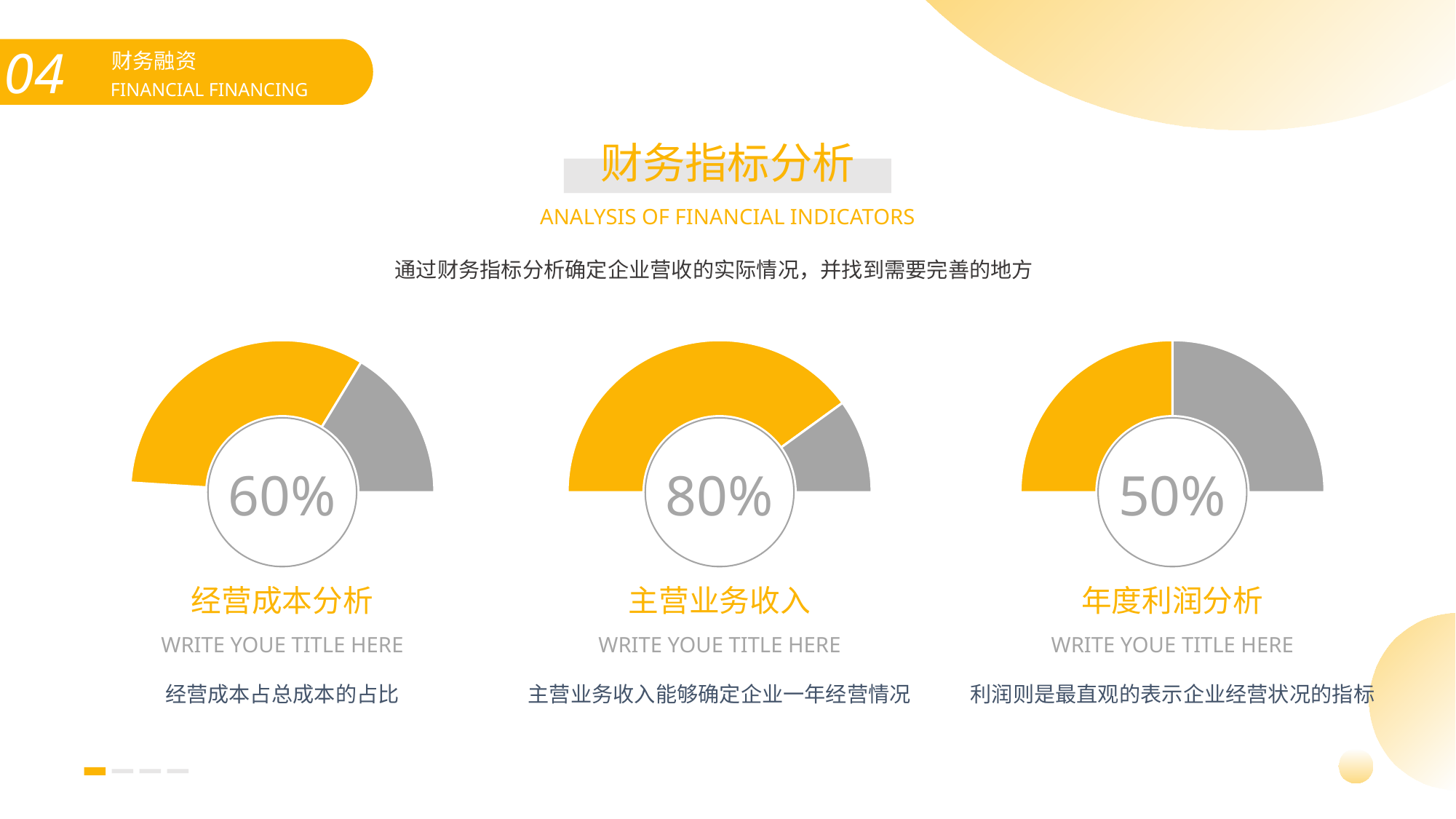
Which is larger, the value on the 经营成本分析 gauge or the value on the 年度利润分析 gauge? 经营成本分析 What value is shown on the gauge chart labelled 主营业务收入? 80% Which of the three gauge charts shows the highest value? 主营业务收入 What is the main title of the slide above the three gauge charts? 财务指标分析 What colour represents the filled portion of each gauge chart? Yellow/orange What kind of chart is used to display the three percentages on the slide? Gauge (semi-circular doughnut) chart What value is shown on the gauge chart labelled 经营成本分析? 60% How many gauge charts are shown on the slide? 3 Which of the three gauge charts shows the lowest value? 年度利润分析 What value is shown on the gauge chart labelled 年度利润分析? 50% What is the difference between the value on the 经营成本分析 gauge and the value on the 年度利润分析 gauge? 10% What is the difference between the value on the 主营业务收入 gauge and the value on the 经营成本分析 gauge? 20%